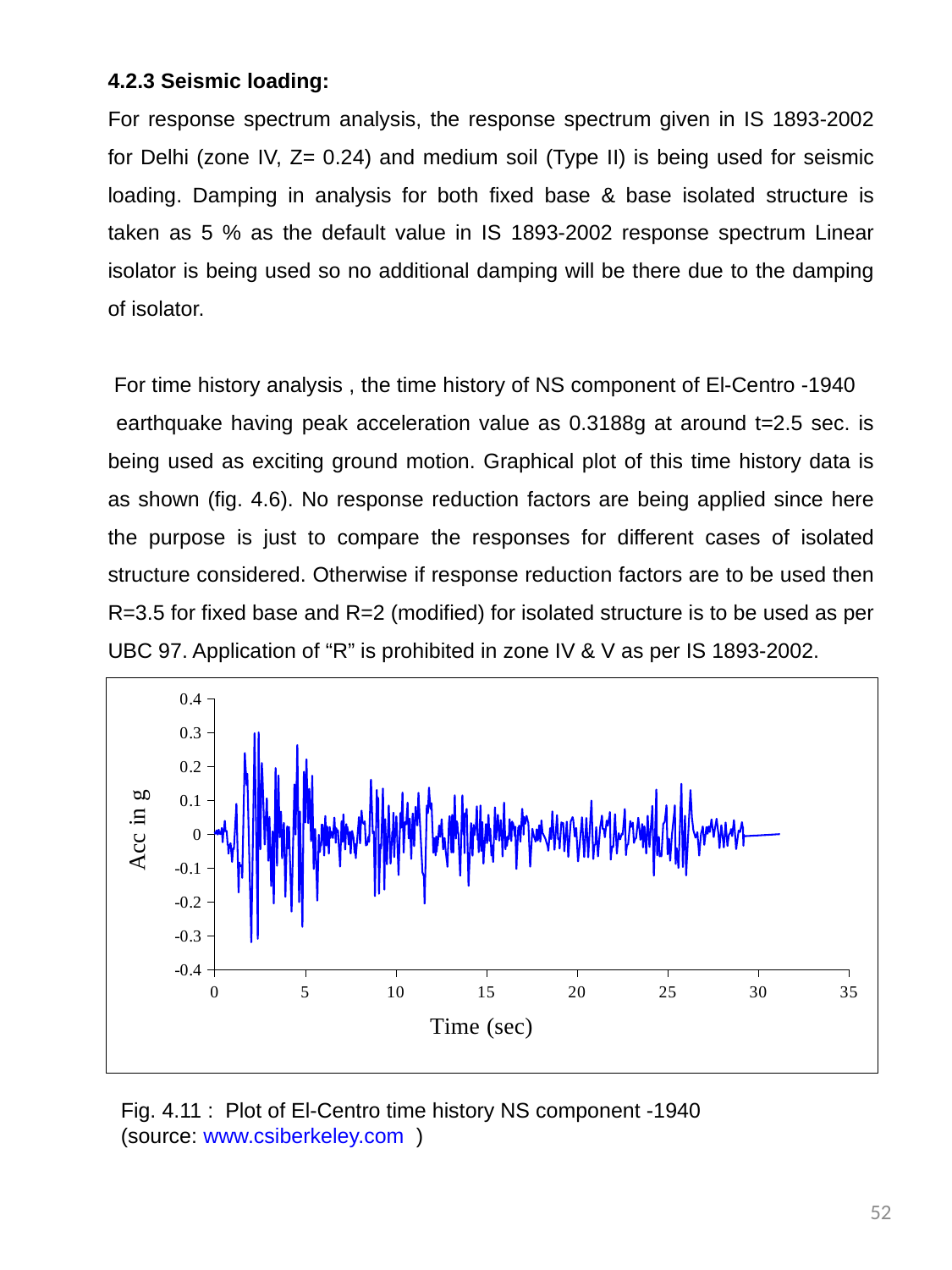
Is the acceleration at around 30 seconds greater or less than 0.1? less What is the highest value shown on the y axis of the chart? 0.4 Is the most negative acceleration in the chart greater or less than -0.2? less Is the peak positive acceleration in the chart greater or less than 0.2? greater Does the amplitude of the acceleration generally increase or decrease as time goes on along the x axis? decrease What is the largest tick value shown on the x axis of the chart? 35 What kind of chart is shown on the slide? line chart What is the label of the y axis of the chart? Acc in g